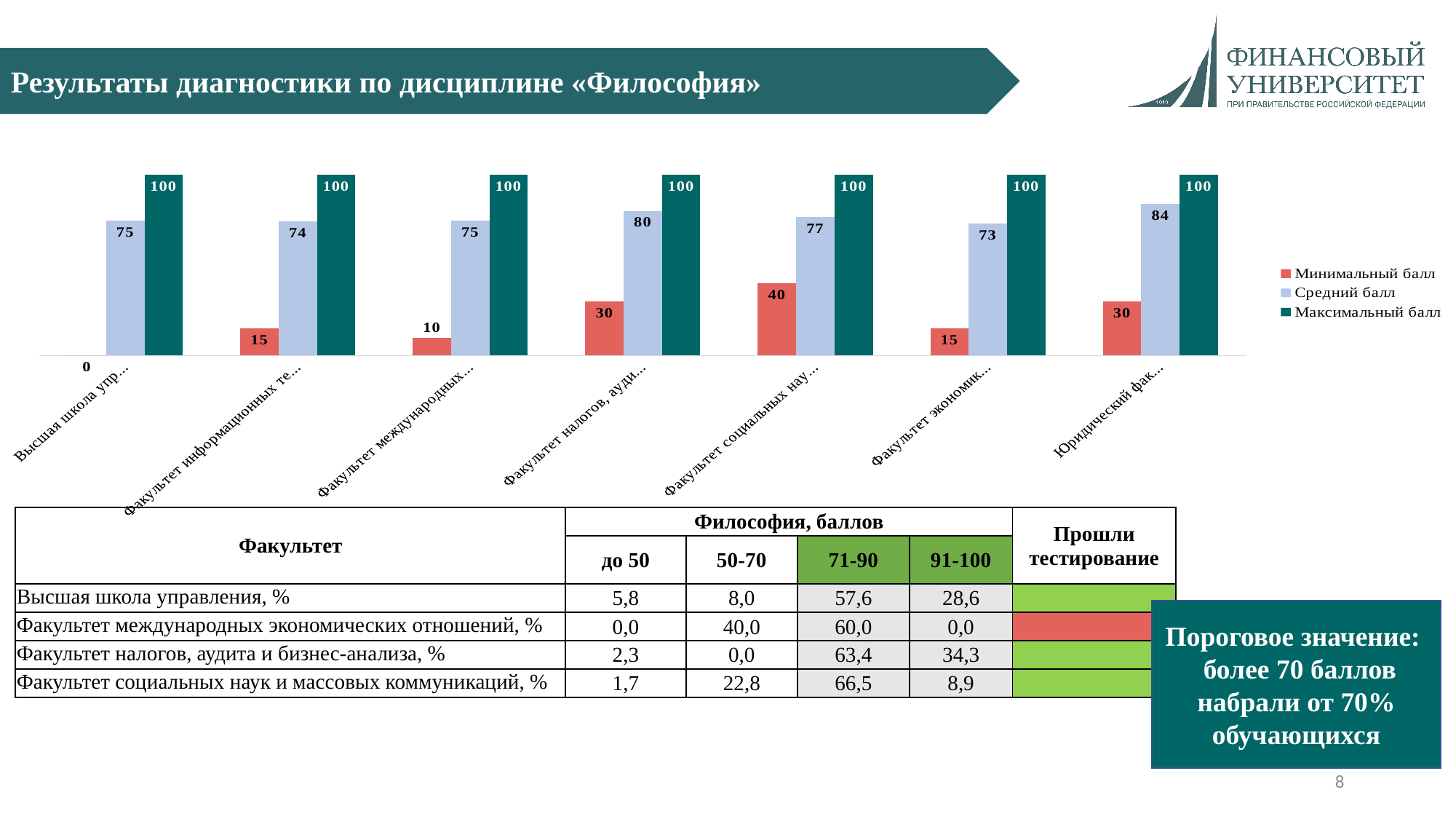
How many faculties (categories) are plotted on the chart? 7 How many series does the chart legend list? 3 What is the Средний балл for the last category, Юридический фак...? 84 Which is larger: the Минимальный балл for Факультет налогов, ауди... or for Факультет информационных те...? Факультет налогов, ауди... What is the Минимальный балл for the first category, Высшая школа упр...? 0 What is the Максимальный балл for Факультет международных...? 100 What kind of chart is shown on the slide? bar chart Which category has the highest Средний балл? Юридический фак... What is the Минимальный балл for the category Факультет социальных нау...? 40 What is the difference between the Средний балл of Юридический фак... and Факультет экономик...? 11 Which series is shown in red on the chart? Минимальный балл Which category has the lowest Средний балл? Факультет экономик...